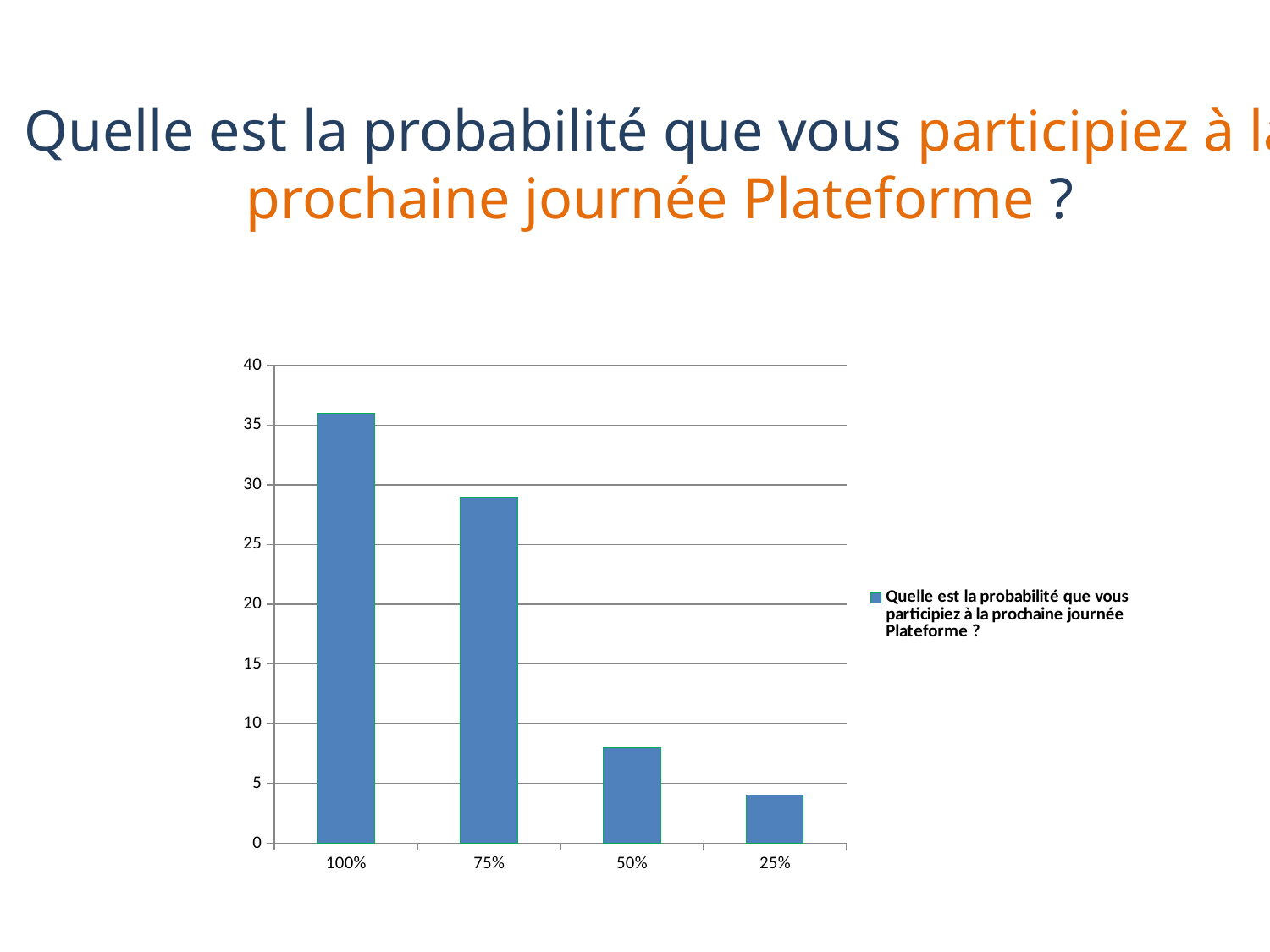
How many series does the legend list? 1 Which category has the lowest bar? 25% Is the value for 75% greater or less than 30? less What kind of chart is shown on the slide? bar chart Do the values rise or fall moving from 100% to 25% along the x axis? fall Is the value for 50% greater or less than 10? less What is the legend entry of the series in the chart? Quelle est la probabilité que vous participiez à la prochaine journée Plateforme ? Is the value for 25% greater or less than 5? less Which category has the highest bar? 100% Which is larger, the value for 75% or the value for 50%? 75% How many categories are shown on the x axis of the chart? 4